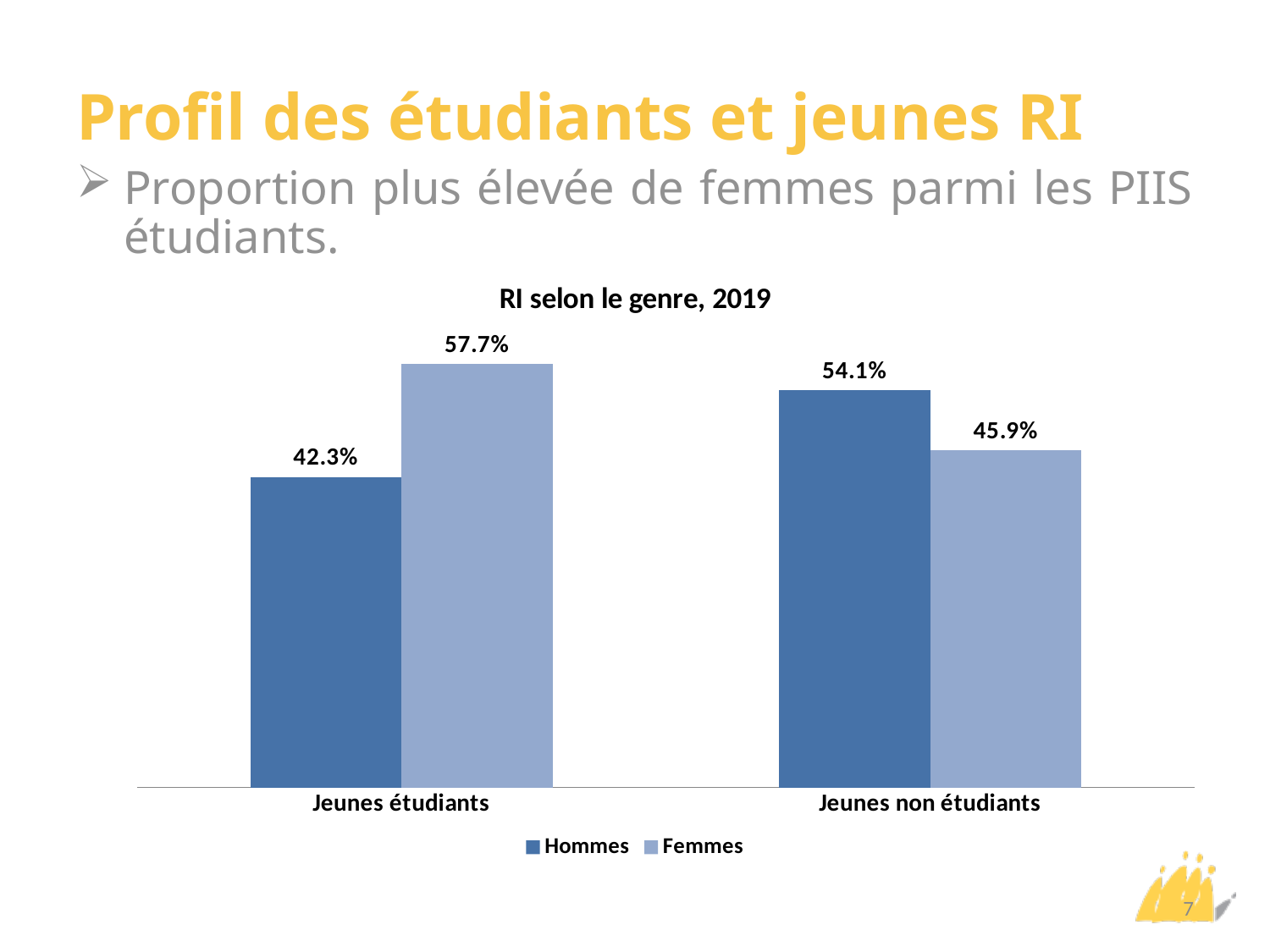
What is the difference between the Hommes and Femmes values for Jeunes non étudiants? 8.2% What is the value for Femmes among Jeunes non étudiants? 45.9% What is the title of the chart? RI selon le genre, 2019 What is the value for Hommes among Jeunes étudiants? 42.3% What is the value for Femmes among Jeunes étudiants? 57.7% How many categories are shown on the x axis? 2 Which bar in the chart has the lowest value? Hommes, Jeunes étudiants What is the difference between the Femmes and Hommes values for Jeunes étudiants? 15.4% How many series does the legend list? 2 Which is larger for Jeunes non étudiants, Hommes or Femmes? Hommes What is the value for Hommes among Jeunes non étudiants? 54.1% Which bar in the chart has the highest value? Femmes, Jeunes étudiants